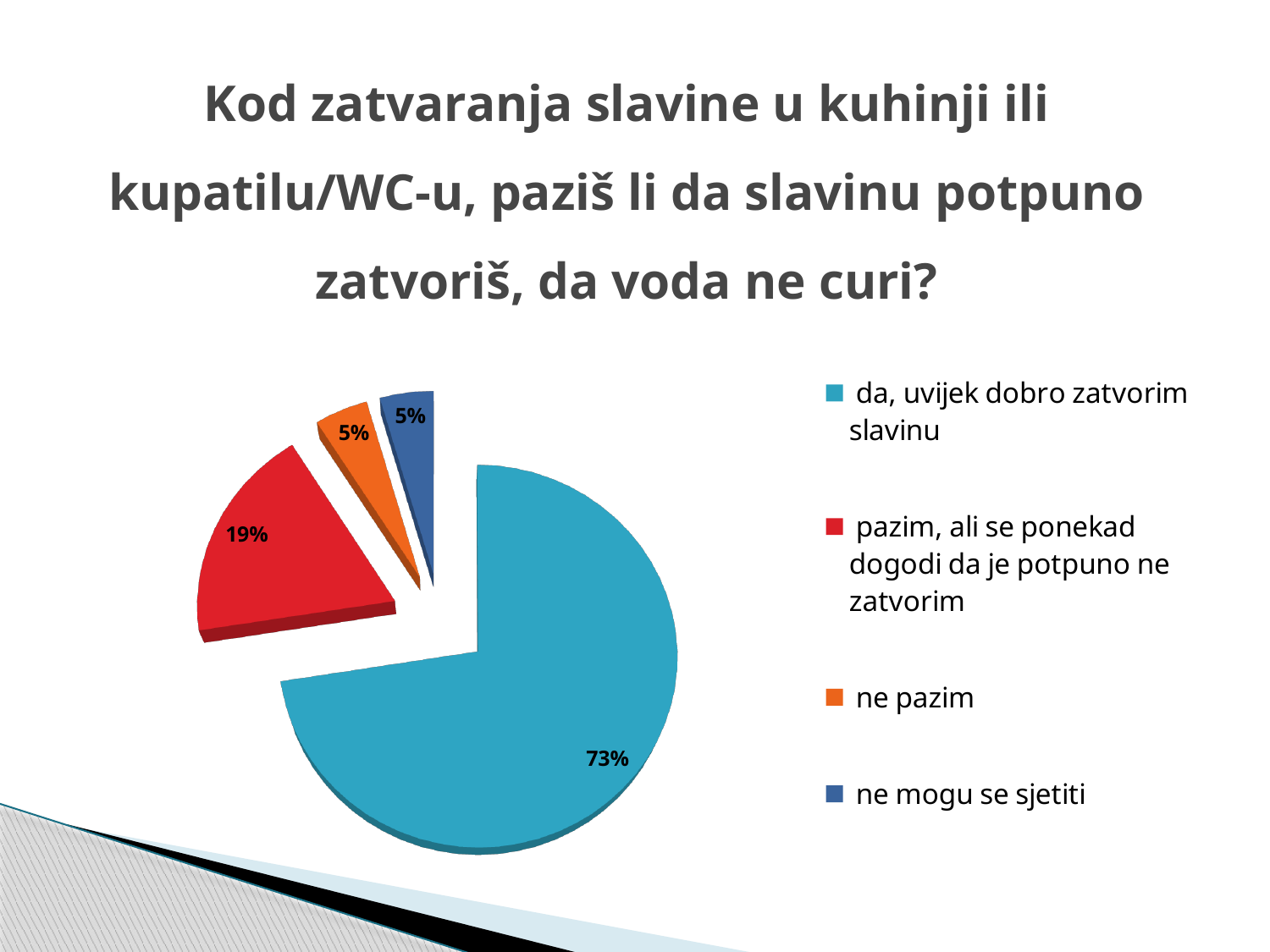
What colour is the slice for "da, uvijek dobro zatvorim slavinu"? teal blue What kind of chart is shown on the slide? pie chart Which category has the largest slice of the pie? da, uvijek dobro zatvorim slavinu What colour is the slice for "ne pazim"? orange How many entries does the legend list? 4 What is the difference between the shares for "da, uvijek dobro zatvorim slavinu" and "pazim, ali se ponekad dogodi da je potpuno ne zatvorim"? 54% What share of the pie does "pazim, ali se ponekad dogodi da je potpuno ne zatvorim" have? 19% What share of the pie does "ne mogu se sjetiti" have? 5% What share of the pie does "da, uvijek dobro zatvorim slavinu" have? 73% Which is larger: the share for "pazim, ali se ponekad dogodi da je potpuno ne zatvorim" or the share for "ne pazim"? pazim, ali se ponekad dogodi da je potpuno ne zatvorim How many slices does the pie chart have? 4